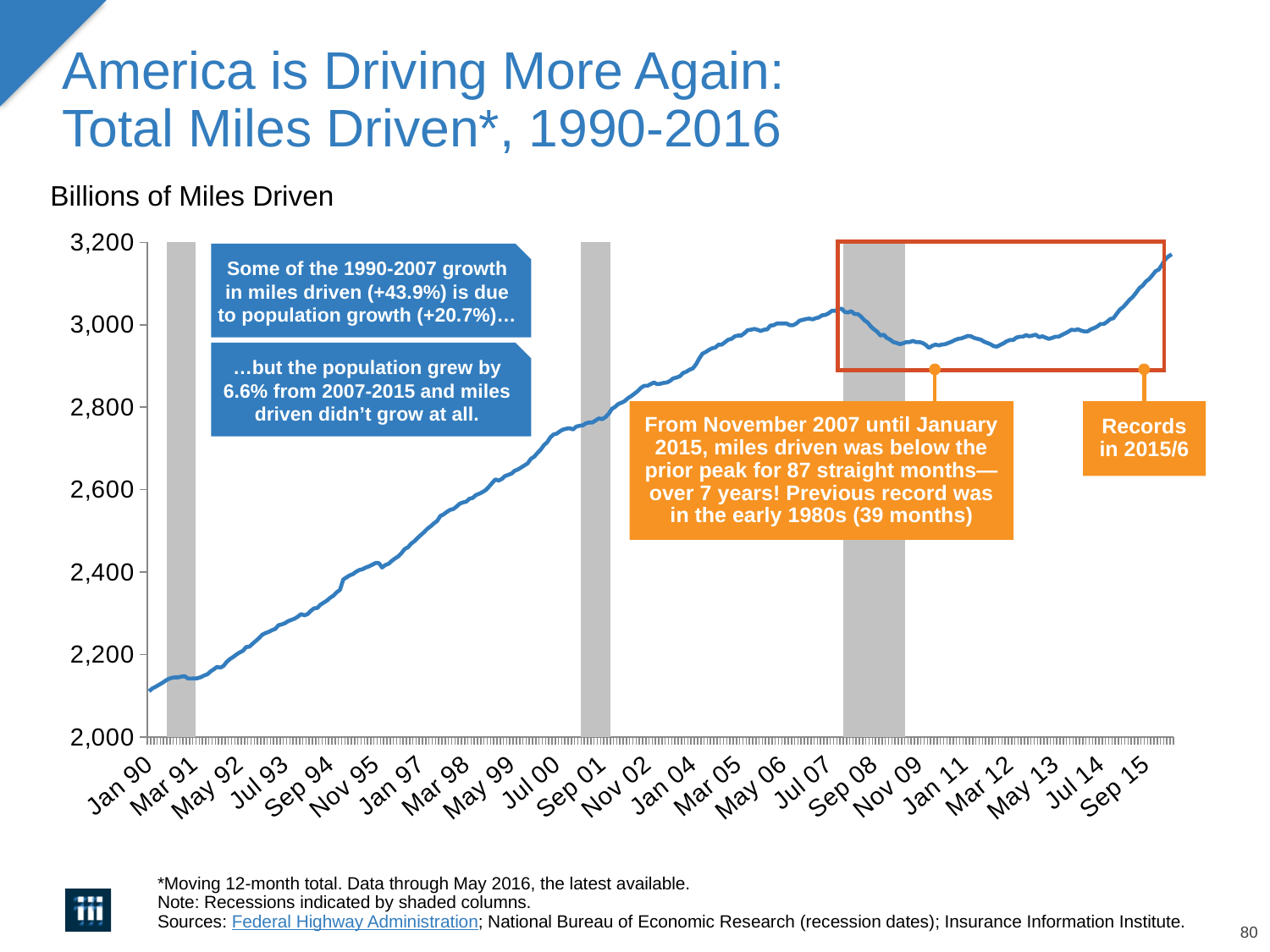
What unit is given for the y axis of the chart? Billions of Miles Driven Is the value for Jul 00 greater or less than 2,600? greater How many labels are shown on the x axis? 23 Is the value for Jan 97 greater or less than 2,600? less Overall, do total miles driven rise or fall from Jan 90 to the end of the series? rise Which x-axis label corresponds to the lowest point on the line? Jan 90 Is the value for Sep 15 greater or less than 3,000? greater What kind of chart is shown on the slide? line chart How many shaded recession columns appear on the chart? 3